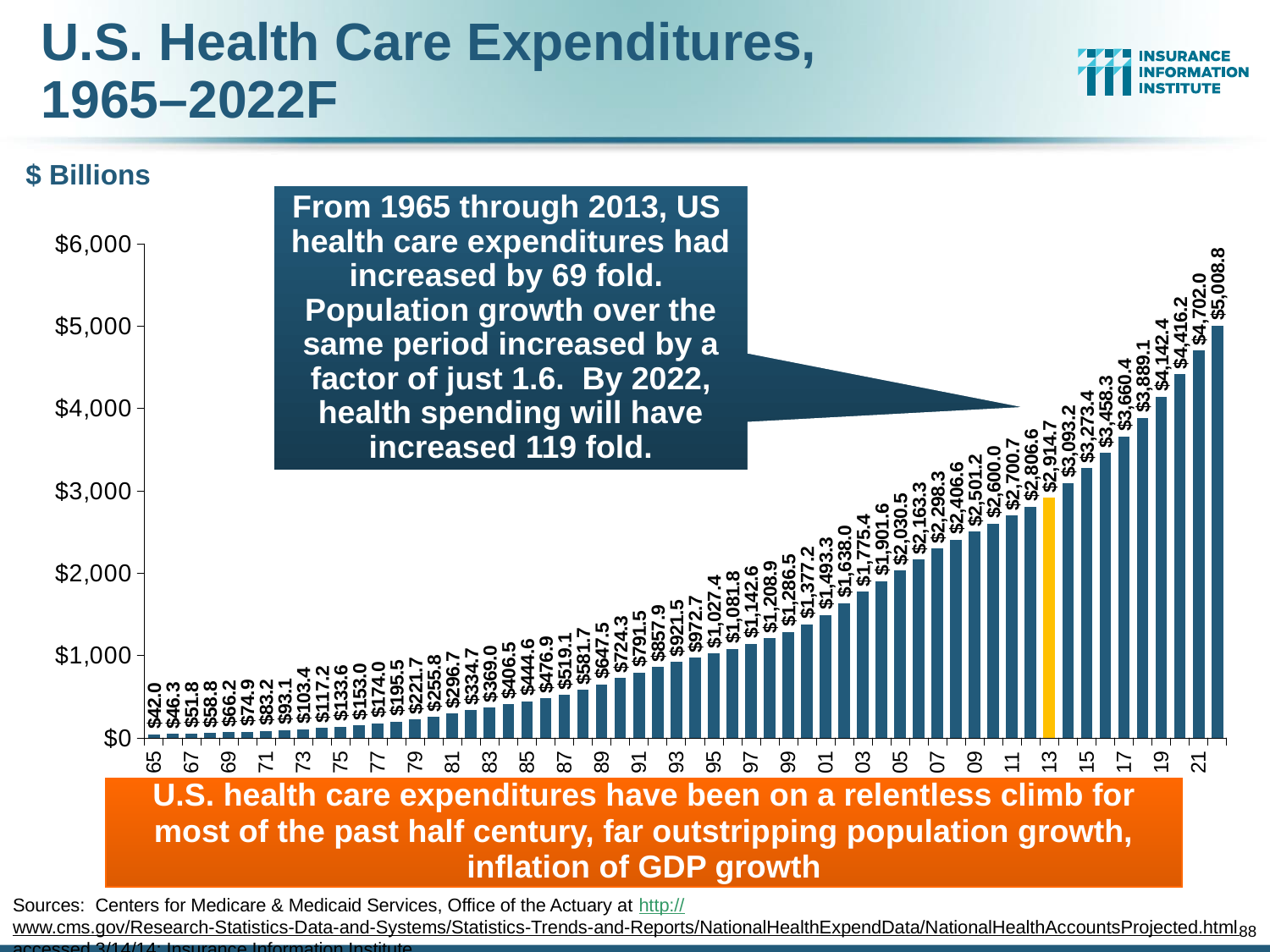
Which is larger, the value for 2005 or the value for 2009? 2009 What is the value of U.S. health care expenditures for 2022F, the last bar? $5,008.8 What type of chart is shown on the slide? Bar chart Which year has the highest health care expenditure value in the chart? 2022F What is the value of U.S. health care expenditures for 2013, the highlighted bar? $2,914.7 Which year has the lowest health care expenditure value in the chart? 1965 What is the difference between the 2022F value ($5,008.8) and the 1965 value ($42.0)? $4,966.8 What is the value of U.S. health care expenditures for 2001? $1,493.3 Do the values generally rise or fall from left to right along the x axis? Rise What is the value of U.S. health care expenditures for 1965? $42.0 What colour is the highlighted bar for 2013? Yellow Is the value for 2017 greater or less than $3,000? greater